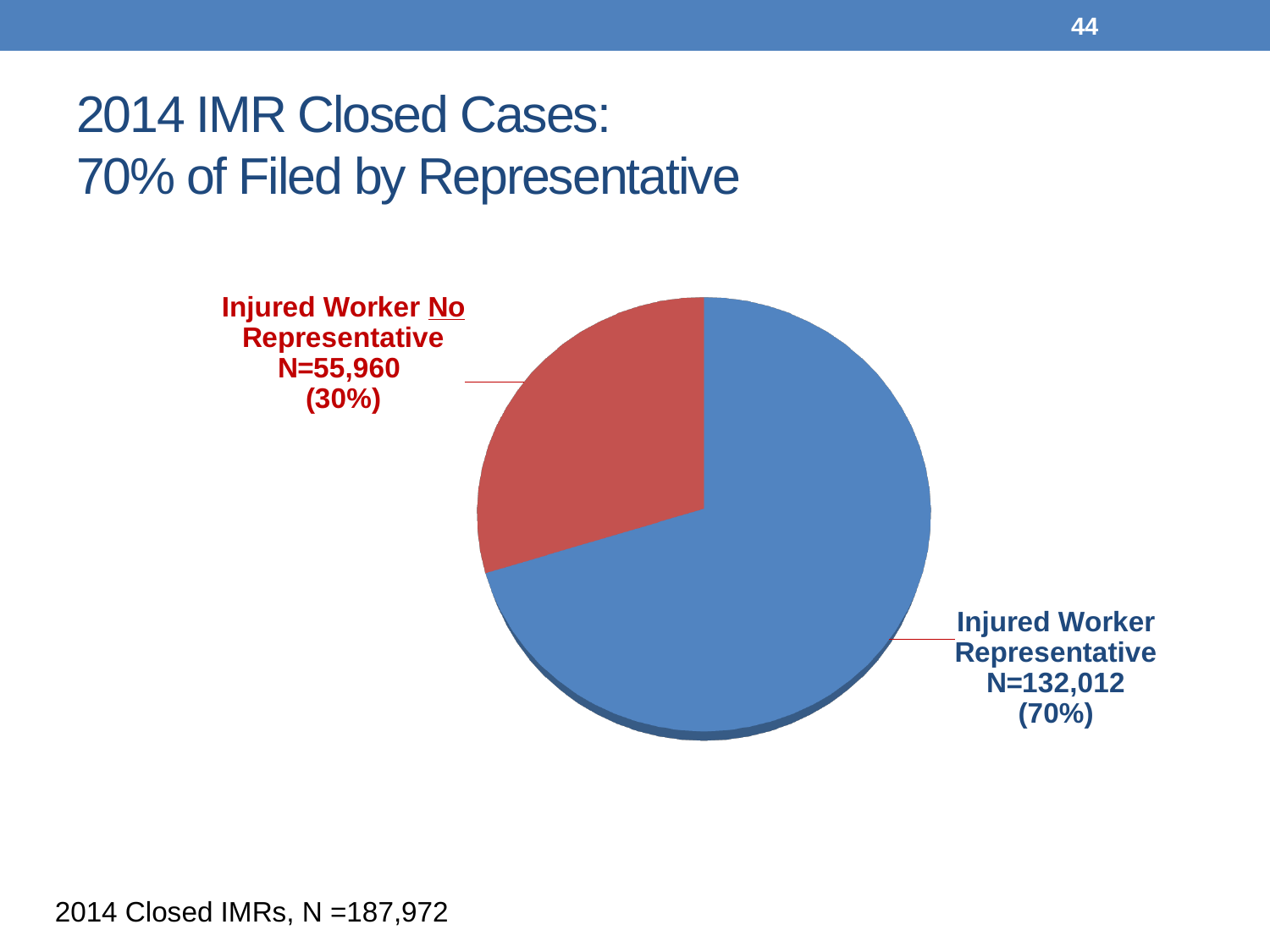
Which is larger, Injured Worker Representative or Injured Worker No Representative? Injured Worker Representative Which slice is the largest? Injured Worker Representative What colour is the Injured Worker No Representative slice? red What share of the pie is Injured Worker No Representative? 30% What is the difference in N between Injured Worker Representative and Injured Worker No Representative? 76,052 How many slices does the pie chart have? 2 Which slice is the smallest? Injured Worker No Representative What is the N value for Injured Worker No Representative? 55,960 What is the N value for Injured Worker Representative? 132,012 What kind of chart is shown on the slide? pie chart What share of the pie is Injured Worker Representative? 70% What is the total N of 2014 Closed IMRs shown on the slide? 187,972